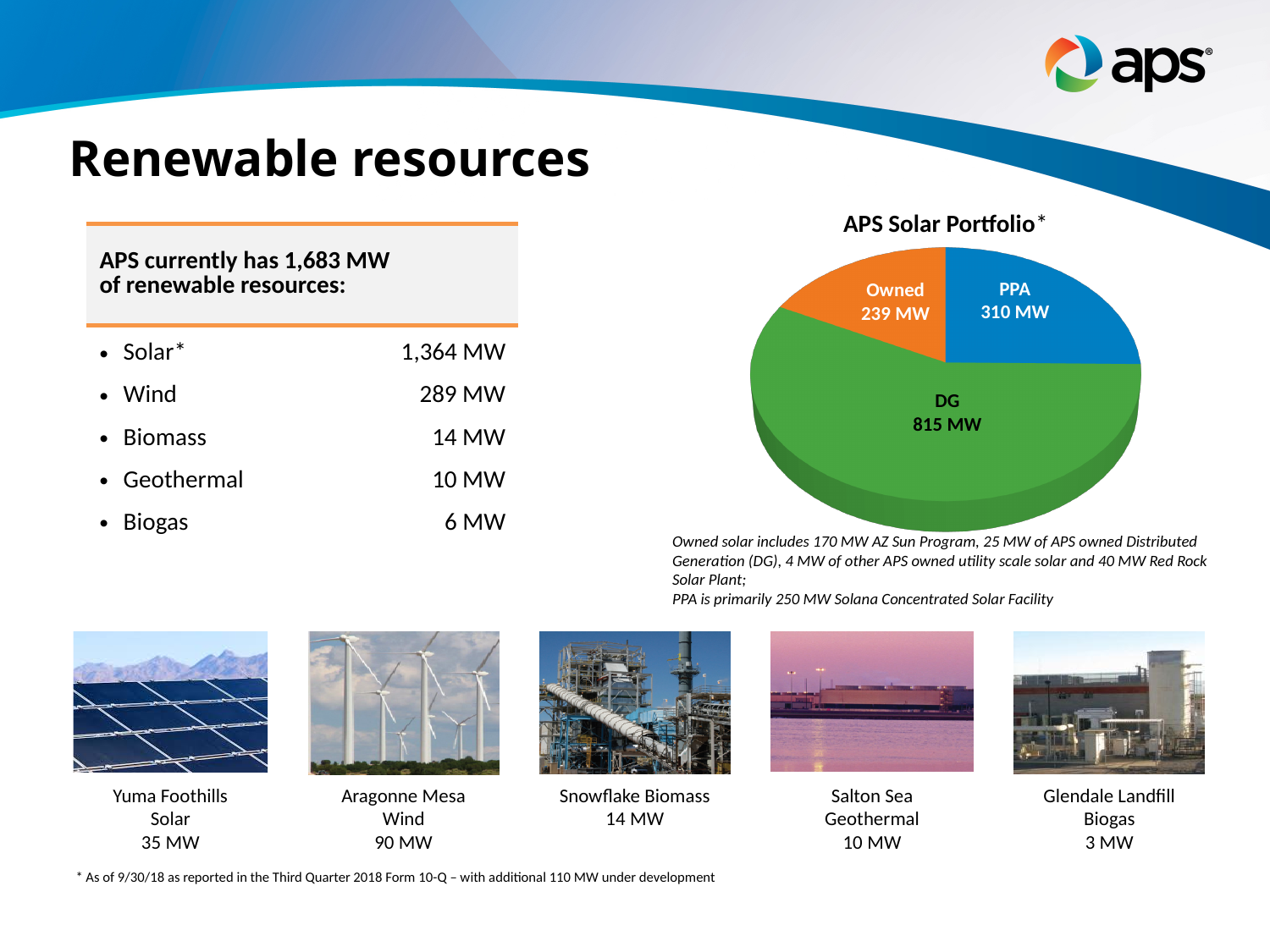
What colour is the DG slice in the APS Solar Portfolio pie chart? Green How many slices does the APS Solar Portfolio pie chart have? 3 In the APS Solar Portfolio pie chart, what is the value for DG? 815 MW Which slice of the APS Solar Portfolio pie chart is the largest? DG In the APS Solar Portfolio pie chart, what is the value for Owned? 239 MW In the APS Solar Portfolio pie chart, which is larger, PPA or Owned? PPA What kind of chart is the APS Solar Portfolio chart? Pie chart In the APS Solar Portfolio pie chart, how much larger is DG than PPA? 505 MW In the APS Solar Portfolio pie chart, what is the value for PPA? 310 MW Which slice of the APS Solar Portfolio pie chart is the smallest? Owned What is the total of all slices in the APS Solar Portfolio pie chart? 1,364 MW In the APS Solar Portfolio pie chart, what is the difference between PPA and Owned? 71 MW